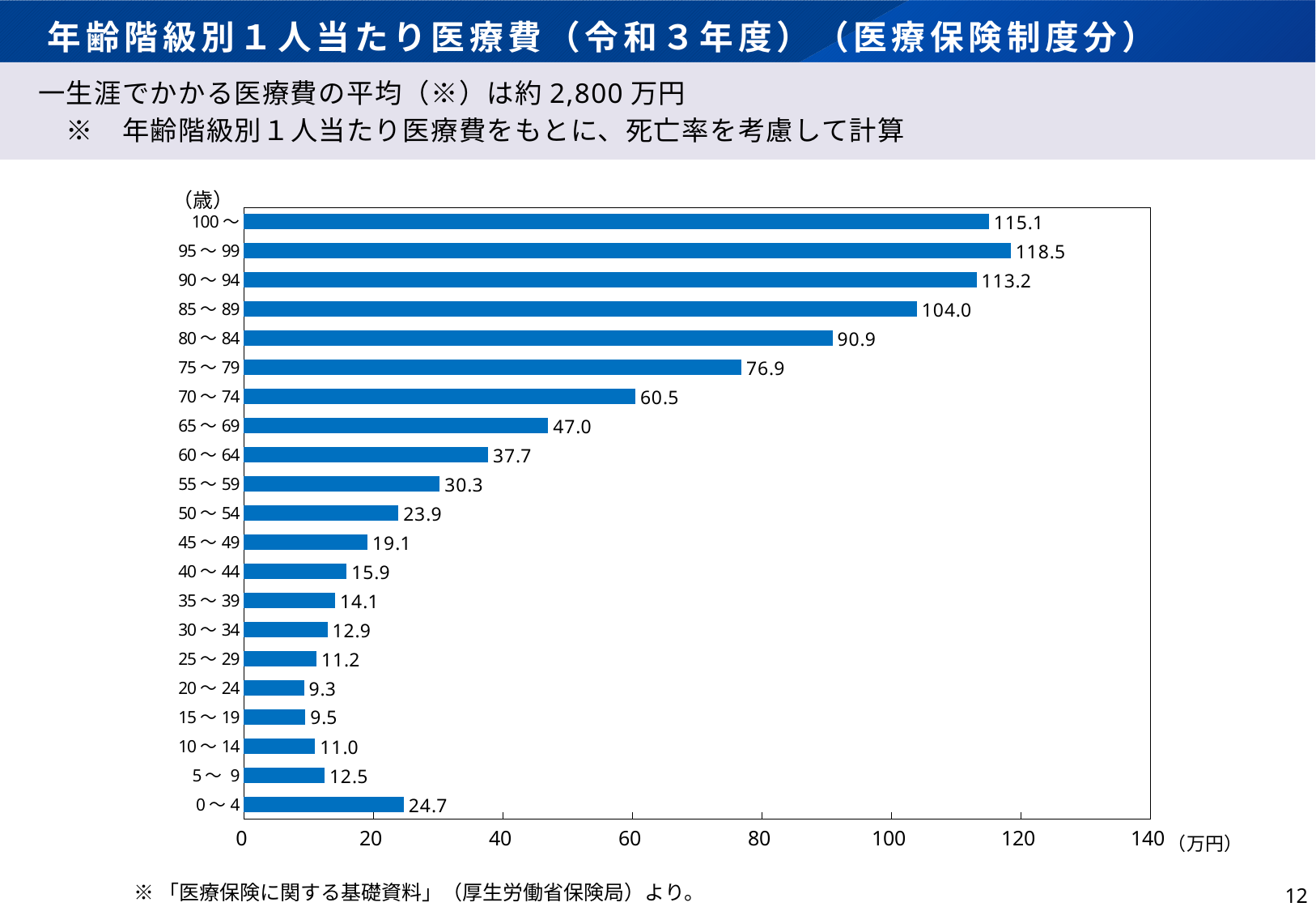
What unit is shown on the horizontal axis of the chart? 万円 What is the per-capita medical expense for the 70～74 age group? 60.5 What value is shown for the 0～4 age group? 24.7 What is the value for the 45～49 age group? 19.1 What is the difference between the values for the 95～99 and 100～ age groups? 3.4 What kind of chart is shown on the slide? Bar chart What is the difference between the values for the 80～84 and 75～79 age groups? 14.0 Which age group has the lowest per-capita medical expense? 20～24 Is the value for the 85～89 age group greater or less than 100? greater How many age groups are shown in the chart? 21 Which has a larger value, the 0～4 age group or the 5～9 age group? 0～4 Which age group has the highest per-capita medical expense? 95～99